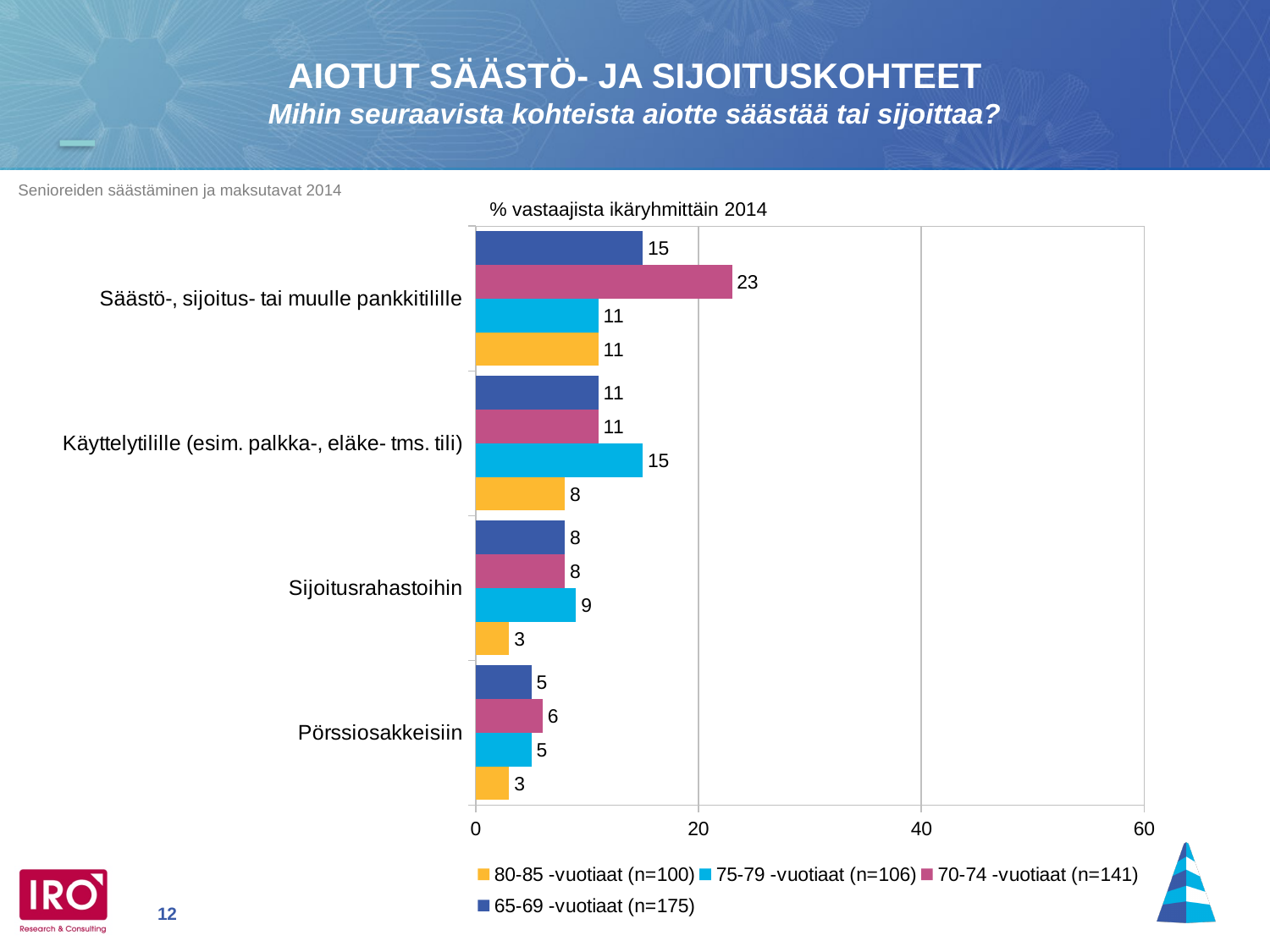
What is the value for 70-74 -vuotiaat (n=141) for Säästö-, sijoitus- tai muulle pankkitilille? 23 Is the value for 70-74 -vuotiaat for Säästö-, sijoitus- tai muulle pankkitilille greater or less than 20? greater Which category has the lowest value for 75-79 -vuotiaat (n=106)? Pörssiosakkeisiin What kind of chart is shown on the slide? Bar chart How many series does the legend list? 4 What is the difference between the 70-74 -vuotiaat and 65-69 -vuotiaat values for Säästö-, sijoitus- tai muulle pankkitilille? 8 What is the value for 80-85 -vuotiaat (n=100) for Sijoitusrahastoihin? 3 What is the value for 75-79 -vuotiaat (n=106) for Käyttelytilille (esim. palkka-, eläke- tms. tili)? 15 Which category has the highest value for 70-74 -vuotiaat (n=141)? Säästö-, sijoitus- tai muulle pankkitilille What is the value for 65-69 -vuotiaat (n=175) for Pörssiosakkeisiin? 5 How many categories are shown on the chart? 4 For Käyttelytilille (esim. palkka-, eläke- tms. tili), which is larger: the value for 75-79 -vuotiaat or for 80-85 -vuotiaat? 75-79 -vuotiaat